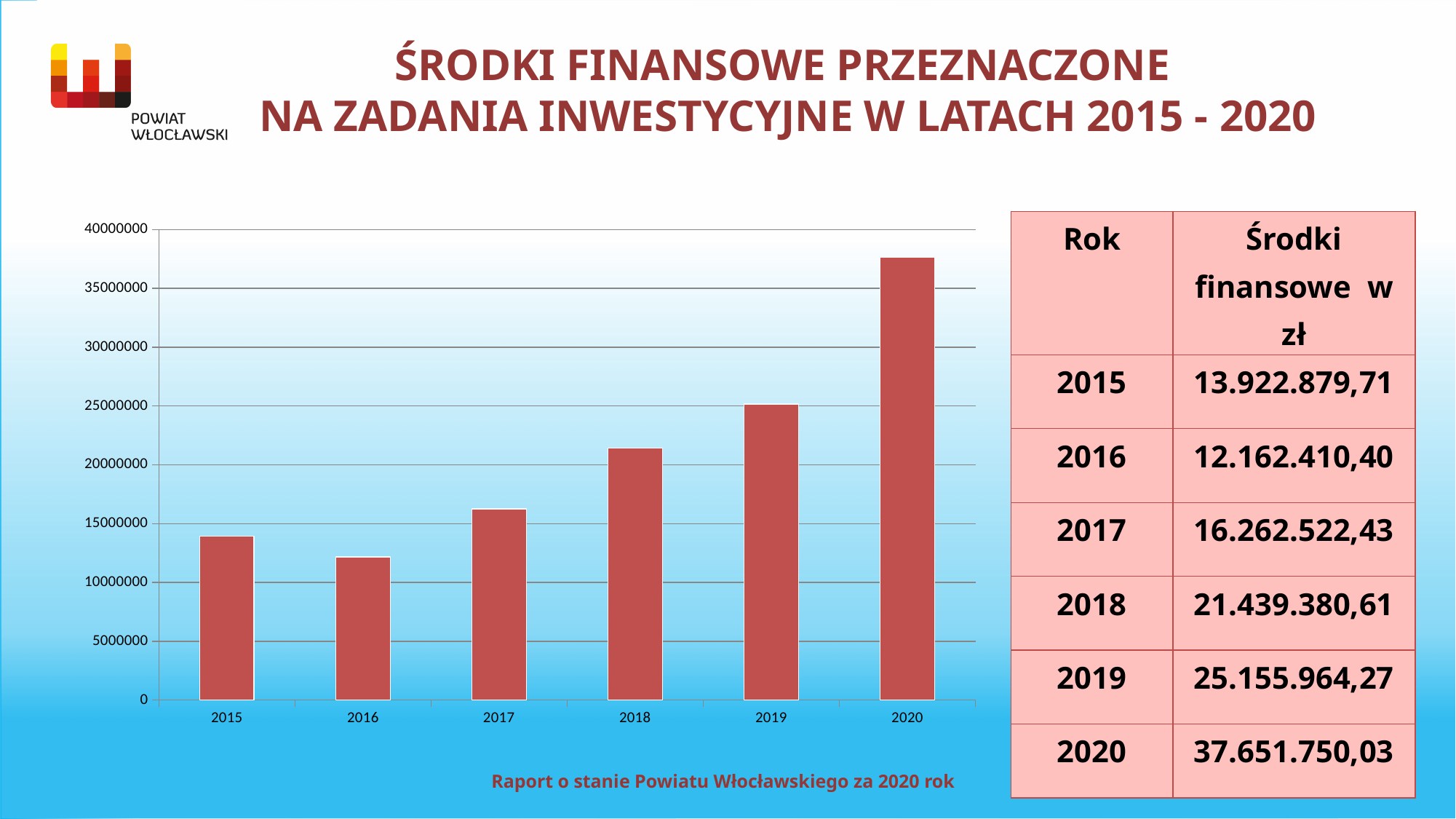
What is the difference between the values for 2020 and 2015? 23.728.870,32 What is the title of the chart on the slide? ŚRODKI FINANSOWE PRZEZNACZONE NA ZADANIA INWESTYCYJNE W LATACH 2015 - 2020 Which year has the highest value in the chart? 2020 Which is larger, the value for 2017 or the value for 2016? 2017 Which year has the lowest value in the chart? 2016 Is the value for 2016 greater or less than 15000000? less What is the value for 2020 according to the slide? 37.651.750,03 What is the value for 2015 according to the slide? 13.922.879,71 What type of chart is shown on the slide? bar chart How many years (bars) are shown in the chart? 6 What is the value for 2018 according to the slide? 21.439.380,61 Is the value for 2018 greater or less than 20000000? greater